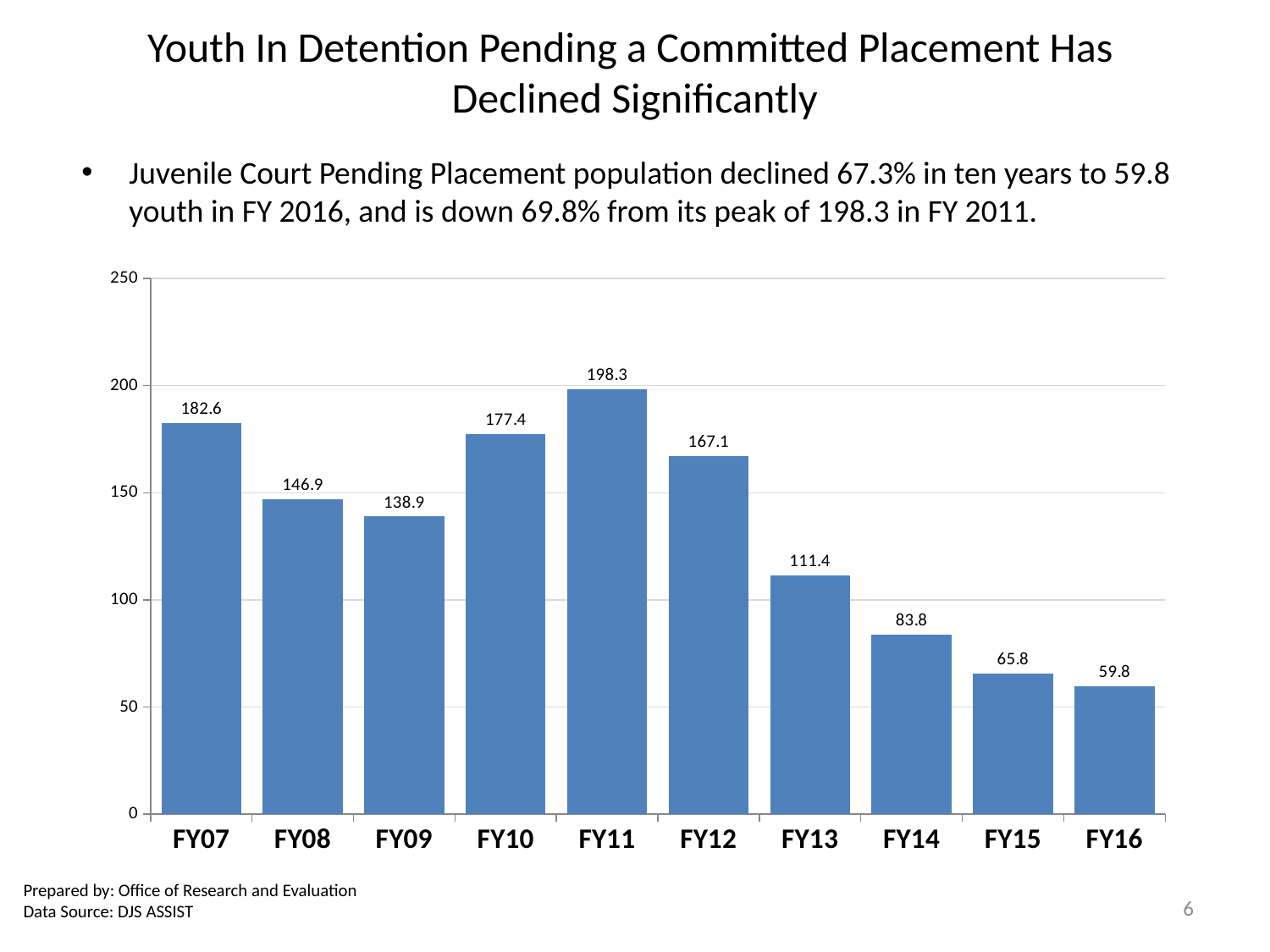
Which is larger, the value for FY07 or the value for FY10? FY07 What is the difference between the values for FY07 and FY08? 35.7 What kind of chart is shown on the slide? bar chart Do the values rise or fall from FY11 to FY16? fall What is the difference between the values for FY11 and FY16? 138.5 What is the value for FY16? 59.8 What is the value for FY09? 138.9 Which fiscal year has the highest value? FY11 What is the value for FY11? 198.3 Which fiscal year has the lowest value? FY16 Is the value for FY13 greater or less than 100? greater How many fiscal years are shown on the x axis? 10